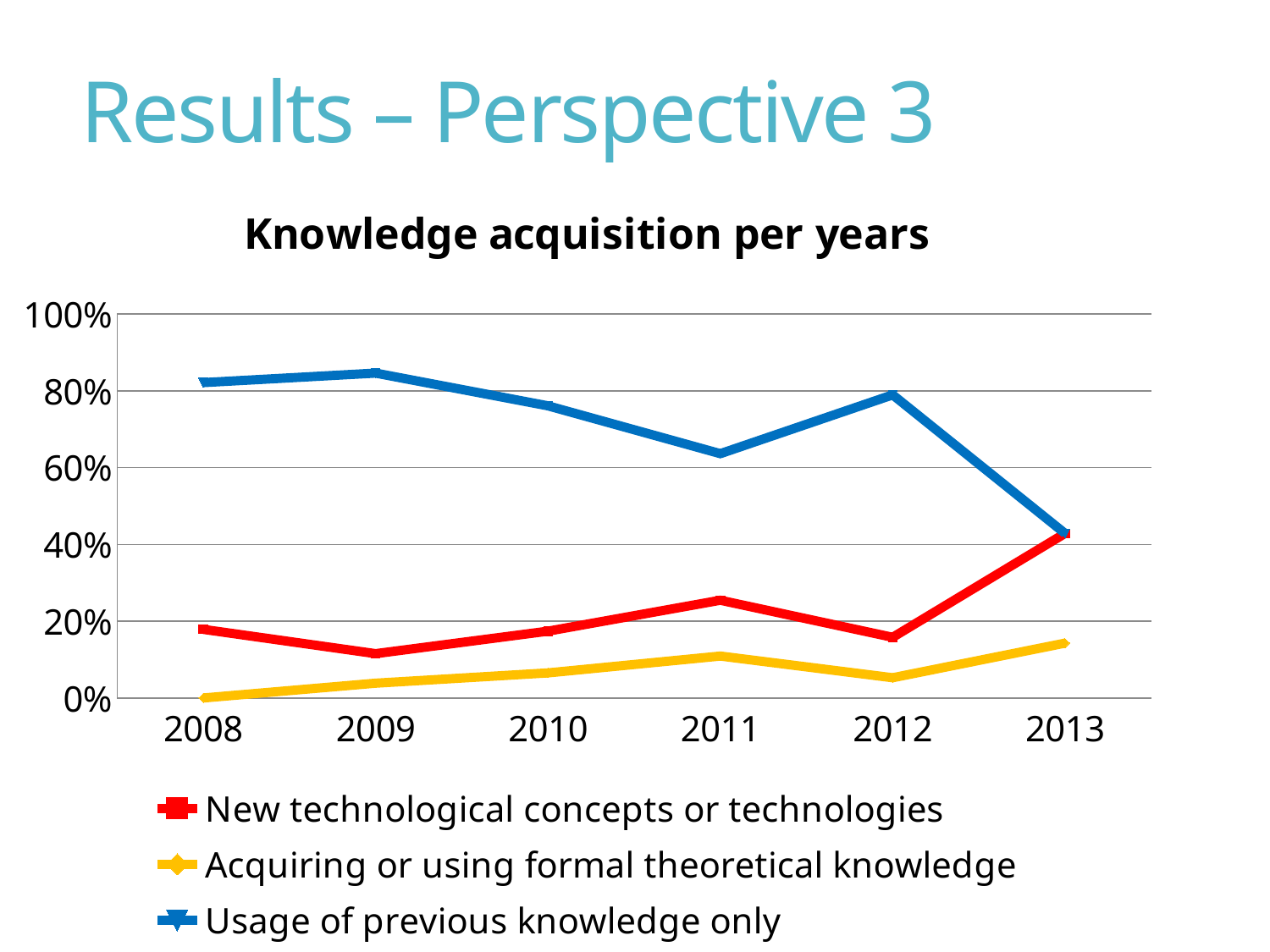
Which colour is used for the 'Usage of previous knowledge only' series? blue What is the chart's title? Knowledge acquisition per years How many years are shown on the x axis? 6 Is the value for 'Usage of previous knowledge only' in 2009 greater or less than 80%? greater Is the value for 'Usage of previous knowledge only' in 2011 greater or less than 80%? less In which year is 'Usage of previous knowledge only' at its lowest? 2013 Is the value for 'Acquiring or using formal theoretical knowledge' in 2013 greater or less than 20%? less In which year is 'New technological concepts or technologies' at its highest? 2013 In 2012, which is larger: 'Usage of previous knowledge only' or 'New technological concepts or technologies'? Usage of previous knowledge only What kind of chart is shown on the slide? line chart How many series does the legend list? 3